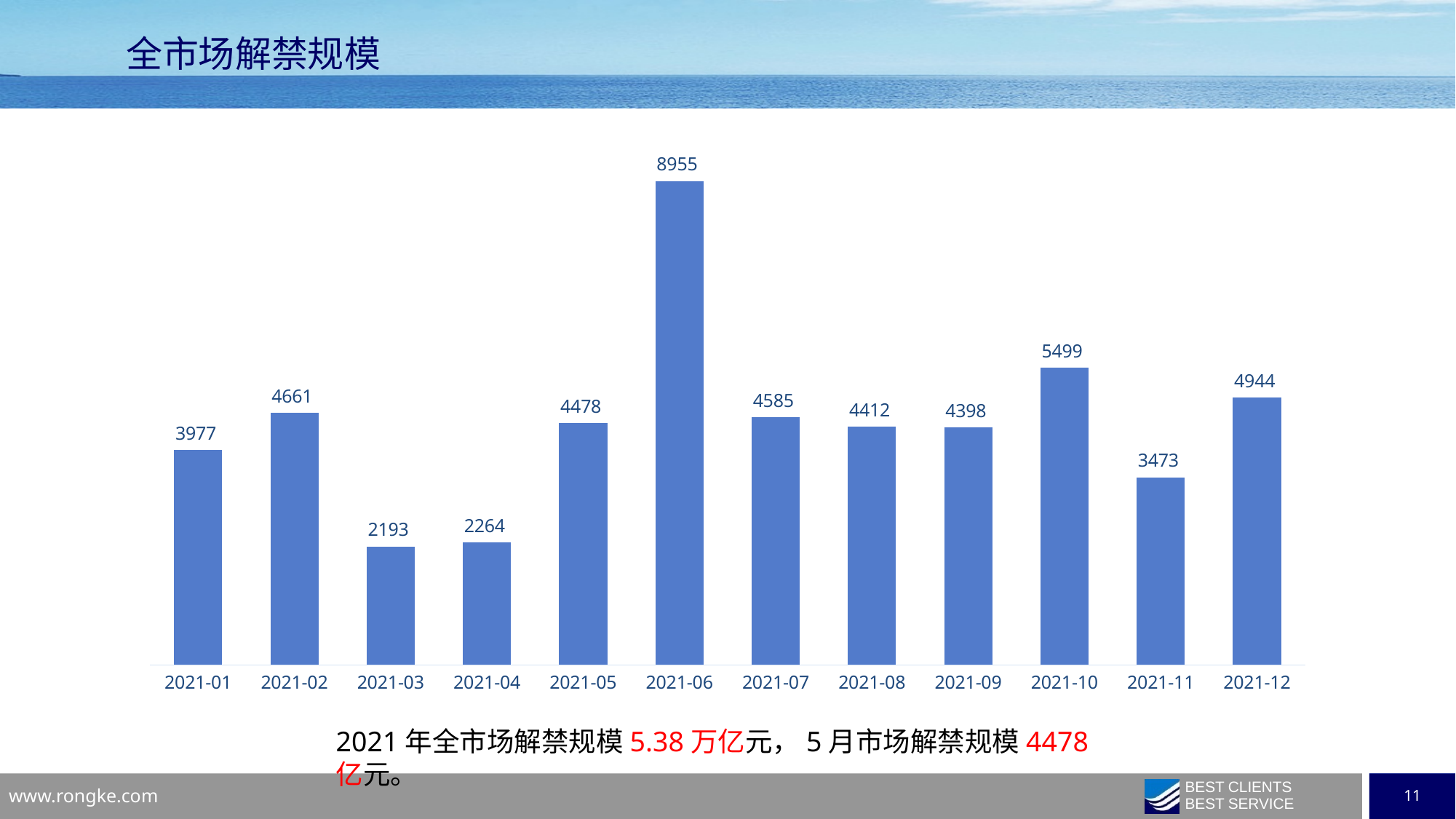
Which month has the highest value? 2021-06 Do the values rise or fall from 2021-09 to 2021-10? rise Which month has the lowest value? 2021-03 What is the value for 2021-03? 2193 Which is larger, the value for 2021-01 or the value for 2021-11? 2021-01 What is the difference between the values for 2021-12 and 2021-11? 1471 Which is larger, the value for 2021-02 or the value for 2021-07? 2021-02 What is the value for 2021-06? 8955 How many months are shown on the x axis? 12 What is the value for 2021-10? 5499 What kind of chart is shown on the slide? bar chart What is the difference between the values for 2021-06 and 2021-05? 4477